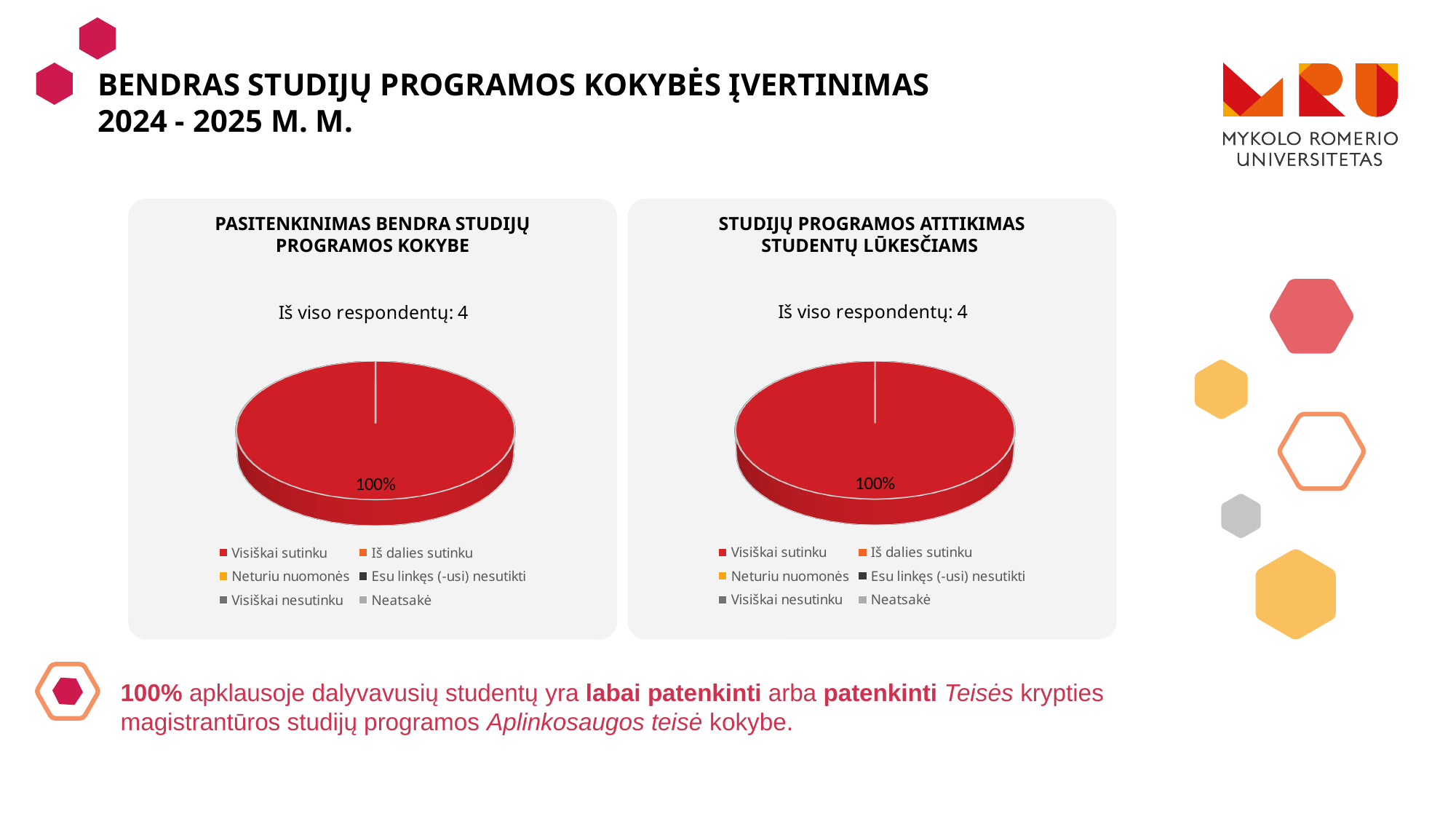
How many respondents are reported for the left chart ("PASITENKINIMAS BENDRA STUDIJŲ PROGRAMOS KOKYBE")? 4 In the left chart ("PASITENKINIMAS BENDRA STUDIJŲ PROGRAMOS KOKYBE"), what colour is the legend marker for "Neturiu nuomonės"? Yellow/orange In the left chart ("PASITENKINIMAS BENDRA STUDIJŲ PROGRAMOS KOKYBE"), which legend category does the single pie slice belong to? Visiškai sutinku How many pie charts are on the slide? 2 How many entries does the legend of the left chart ("PASITENKINIMAS BENDRA STUDIJŲ PROGRAMOS KOKYBE") list? 6 How many respondents are reported for the right chart ("STUDIJŲ PROGRAMOS ATITIKIMAS STUDENTŲ LŪKESČIAMS")? 4 In the left chart ("PASITENKINIMAS BENDRA STUDIJŲ PROGRAMOS KOKYBE"), what percentage is shown on the pie? 100% How many entries does the legend of the right chart ("STUDIJŲ PROGRAMOS ATITIKIMAS STUDENTŲ LŪKESČIAMS") list? 6 What kind of chart is shown under the title "PASITENKINIMAS BENDRA STUDIJŲ PROGRAMOS KOKYBE"? Pie chart What is the title of the chart on the right side of the slide? STUDIJŲ PROGRAMOS ATITIKIMAS STUDENTŲ LŪKESČIAMS In the right chart ("STUDIJŲ PROGRAMOS ATITIKIMAS STUDENTŲ LŪKESČIAMS"), what percentage is shown on the pie? 100% In the right chart ("STUDIJŲ PROGRAMOS ATITIKIMAS STUDENTŲ LŪKESČIAMS"), what share of the pie does "Visiškai sutinku" take? 100%